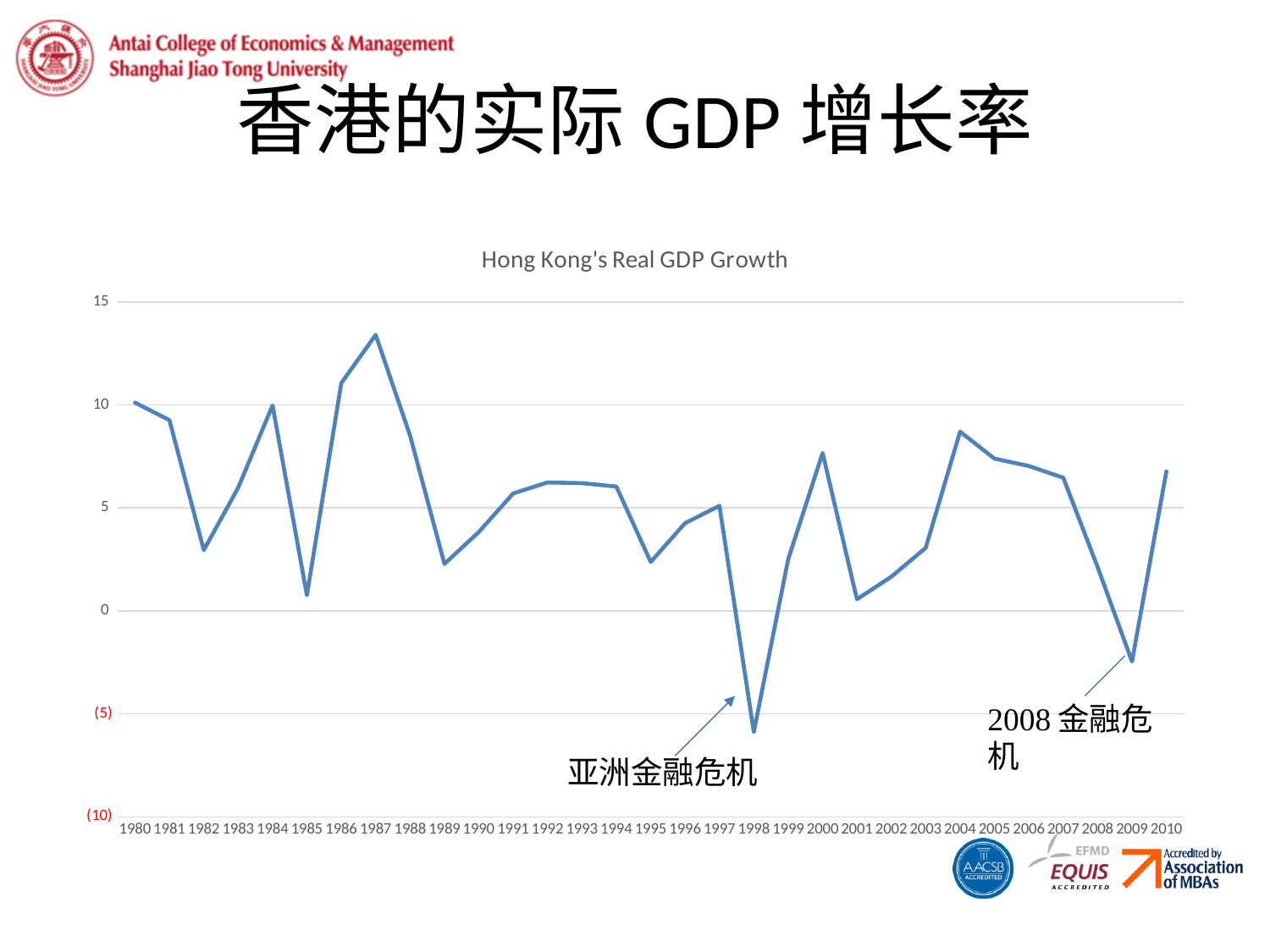
Is the value for 2004 greater or less than 5? greater Which year has the larger real GDP growth, 2000 or 2001? 2000 In which year does Hong Kong's real GDP growth reach its highest value? 1987 How many years are plotted along the x axis of the chart? 31 Is the value for 1998 greater or less than 0? less Does Hong Kong's real GDP growth rise or fall from 1997 to 1998? fall Which event does the annotation near the 1998 dip label? 亚洲金融危机 In which year does Hong Kong's real GDP growth reach its lowest value? 1998 Is the value for 2009 greater or less than 0? less What kind of chart is shown on the slide? line chart What is the title of the chart? Hong Kong's Real GDP Growth